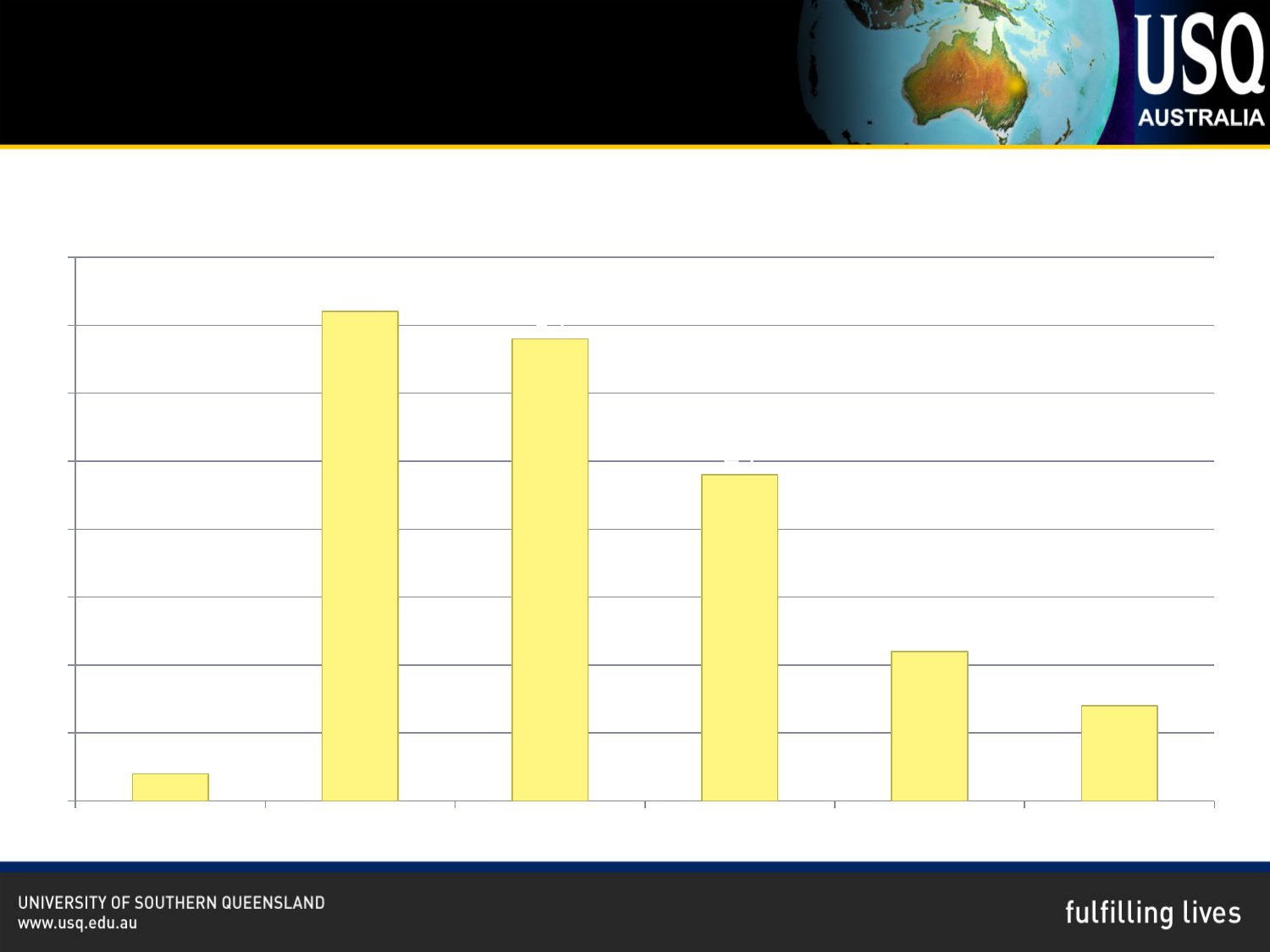
What kind of chart is shown on the slide? bar chart Which is taller, the fifth bar from the left or the sixth bar from the left? the fifth bar Do the bar heights rise or fall from the second bar to the sixth bar? fall What colour are the bars in the chart? yellow Which is taller, the second bar from the left or the third bar from the left? the second bar Which is taller, the fourth bar from the left or the fifth bar from the left? the fourth bar Which bar is the shortest in the chart, counting from the left? the first bar Do the bar heights rise or fall from the first bar to the second bar? rise Which bar is the tallest in the chart, counting from the left? the second bar How many bars are plotted in the chart? 6